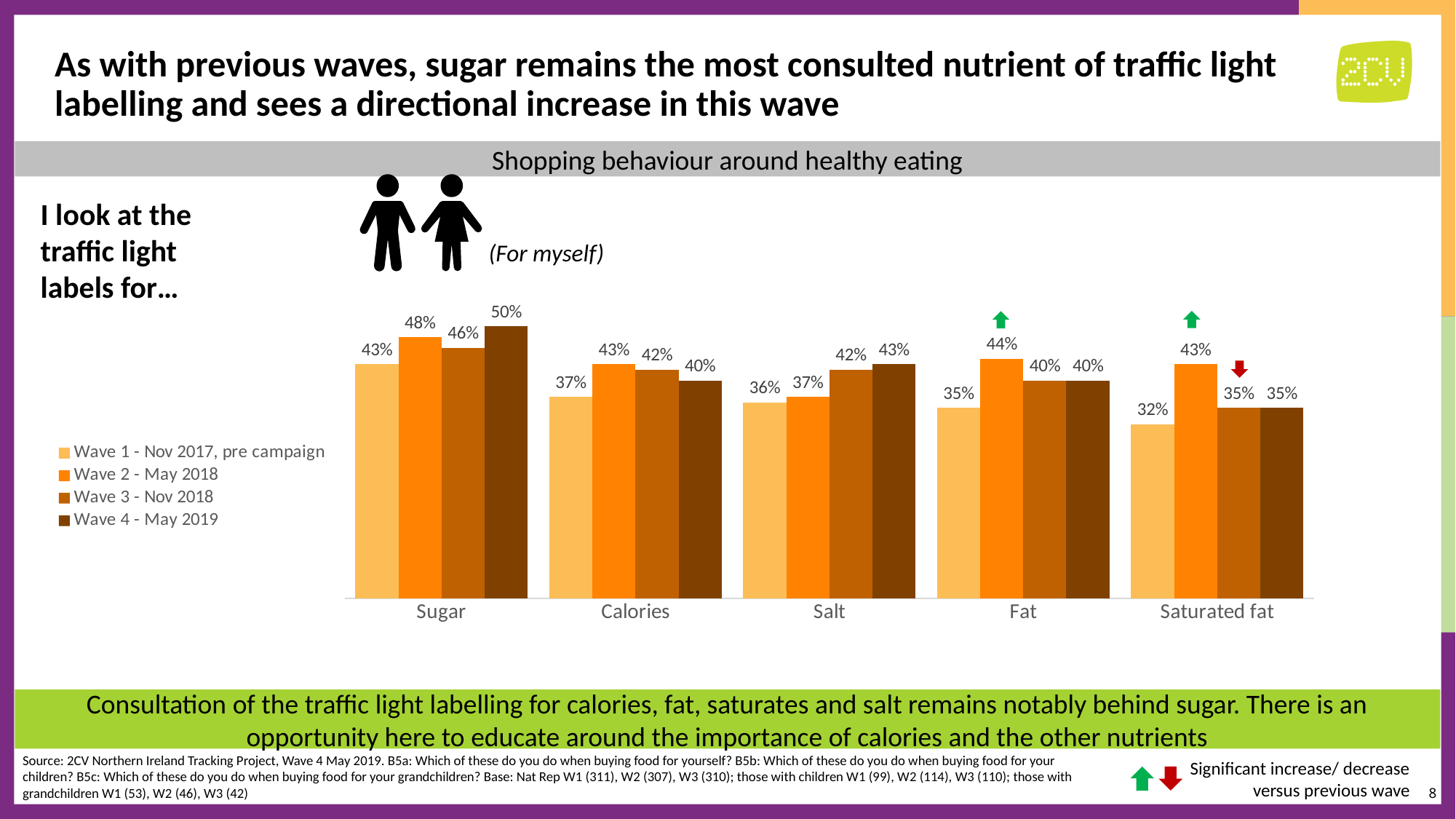
What is the Wave 1 - Nov 2017, pre campaign value for Saturated fat? 32% What kind of chart is shown on the slide? Bar chart Do the Wave 1 - Nov 2017, pre campaign values rise or fall from Sugar to Saturated fat along the x axis? Fall What is the difference between the Wave 4 - May 2019 value for Sugar and the Wave 4 - May 2019 value for Saturated fat? 15% Which is larger for Calories: the Wave 2 - May 2018 value or the Wave 4 - May 2019 value? Wave 2 - May 2018 How many series does the legend list? 4 What is the Wave 2 - May 2018 value for Fat? 44% How many categories are shown on the x axis of the chart? 5 What is the Wave 4 - May 2019 value for Sugar? 50% Which category has the highest Wave 4 - May 2019 value? Sugar What is the Wave 3 - Nov 2018 value for Salt? 42% Which category has the lowest Wave 1 - Nov 2017, pre campaign value? Saturated fat